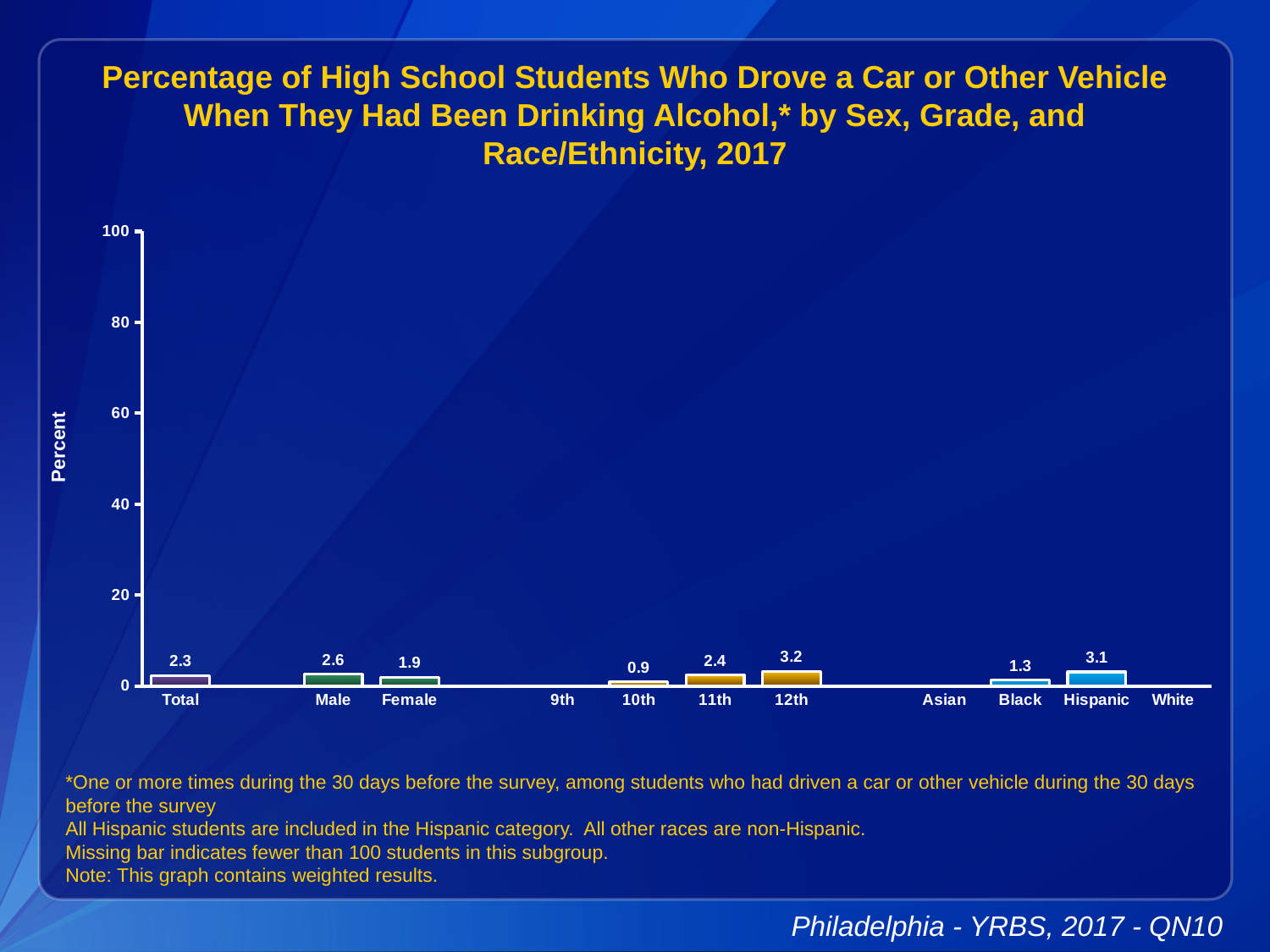
Which is larger, the value for 11th grade or the value for 12th grade? 12th What kind of chart is shown on the slide? bar chart Which category has the lowest value among those with a bar shown? 10th What is the value for Total? 2.3 What is the label of the y axis? Percent What is the value for Male? 2.6 Is the value for Black greater or less than 20? less What is the value for 12th grade? 3.2 Which category has the highest value? 12th What is the value for Hispanic? 3.1 How many categories are labeled on the x axis? 11 What is the difference between the Male and Female values? 0.7